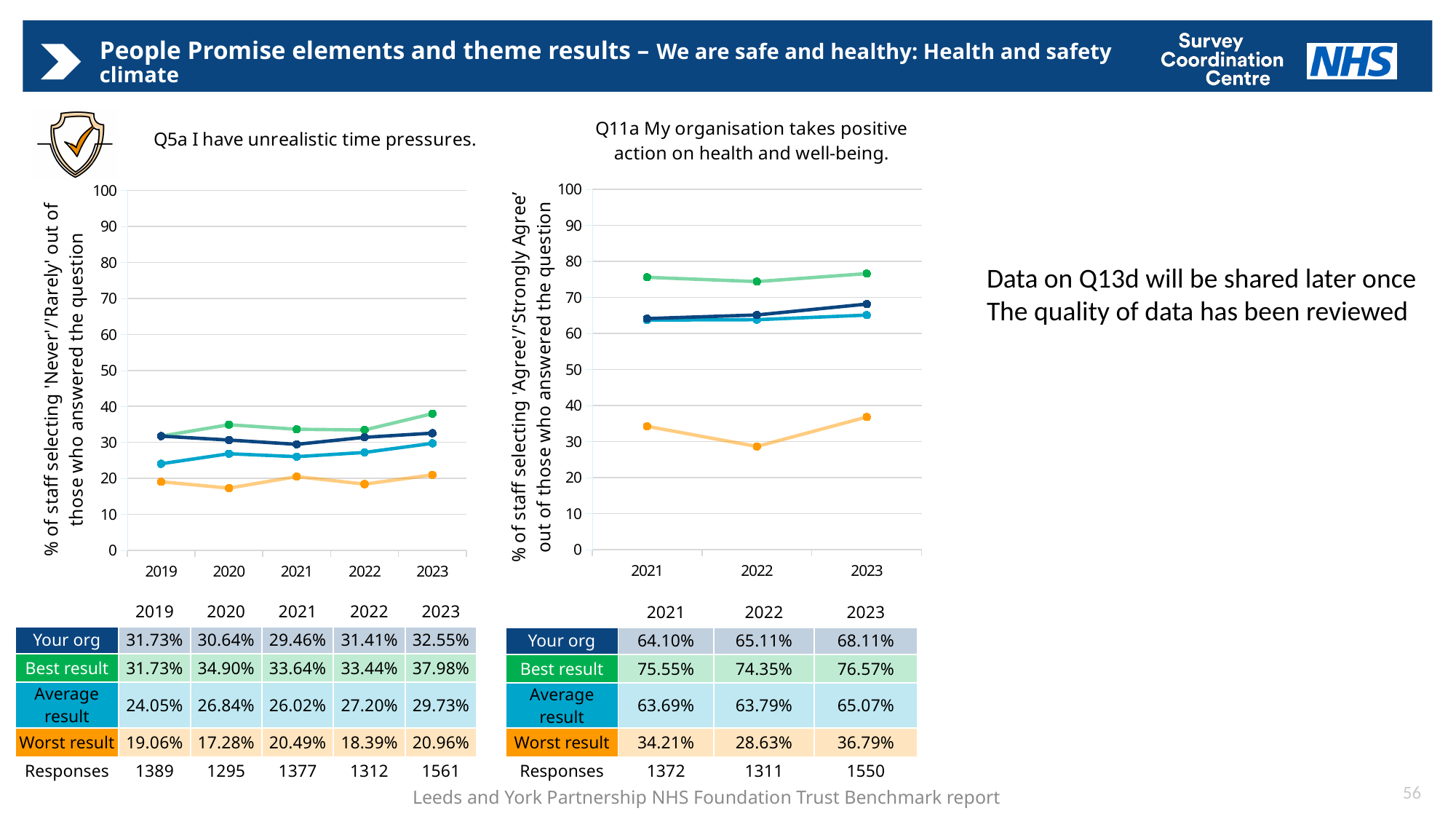
In the Q5a chart, which year has the highest 'Best result' value? 2023 In the Q11a chart, does the 'Your org' line rise or fall from 2021 to 2023? Rise In the Q5a chart, which is larger in 2020: the 'Your org' value or the 'Average result' value? Your org In the Q11a 'My organisation takes positive action on health and well-being' chart, what is the 'Best result' value for 2022? 74.35% How many years are plotted on the x axis of the Q5a chart? 5 What kind of chart is used for Q5a 'I have unrealistic time pressures'? Line chart In the Q11a chart, which year has the lowest 'Worst result' value? 2022 In the Q11a chart, by how many percentage points did the 'Your org' value change from 2021 to 2023? 4.01 percentage points In the Q5a 'I have unrealistic time pressures' chart, what is the 'Your org' value for 2023? 32.55% How many result series (Your org, Best result, Average result, Worst result) are plotted in the Q11a chart? 4 In the Q5a table, how many responses were recorded for 2023? 1561 In the Q11a chart, is the 'Best result' value for 2023 greater or less than 70? greater